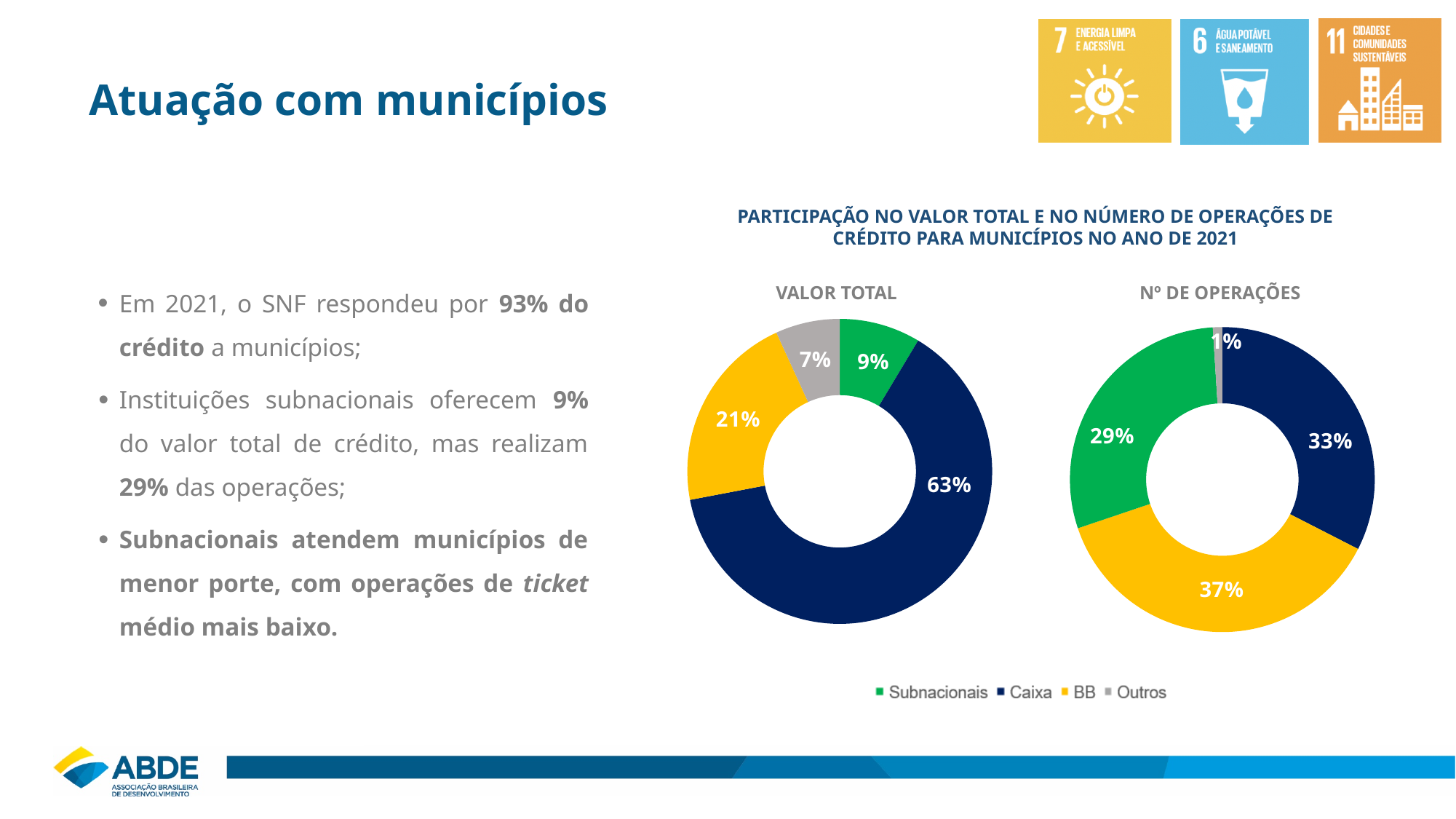
What type of chart is the VALOR TOTAL chart? Pie (donut) chart In the VALOR TOTAL chart, which category has the largest share? Caixa In the VALOR TOTAL chart, what is the difference between the shares of Caixa and BB? 42% How many entries does the legend list? 4 In the VALOR TOTAL chart, what share does Caixa hold? 63% In the Nº DE OPERAÇÕES chart, what share does Outros hold? 1% In the Nº DE OPERAÇÕES chart, which category has the largest share? BB In the Nº DE OPERAÇÕES chart, which is larger: the share of BB or the share of Caixa? BB In the Nº DE OPERAÇÕES chart, what share do Subnacionais hold? 29% Which colour represents Subnacionais in the charts? Green In the Nº DE OPERAÇÕES chart, which category has the smallest share? Outros In the VALOR TOTAL chart, what share does BB hold? 21%